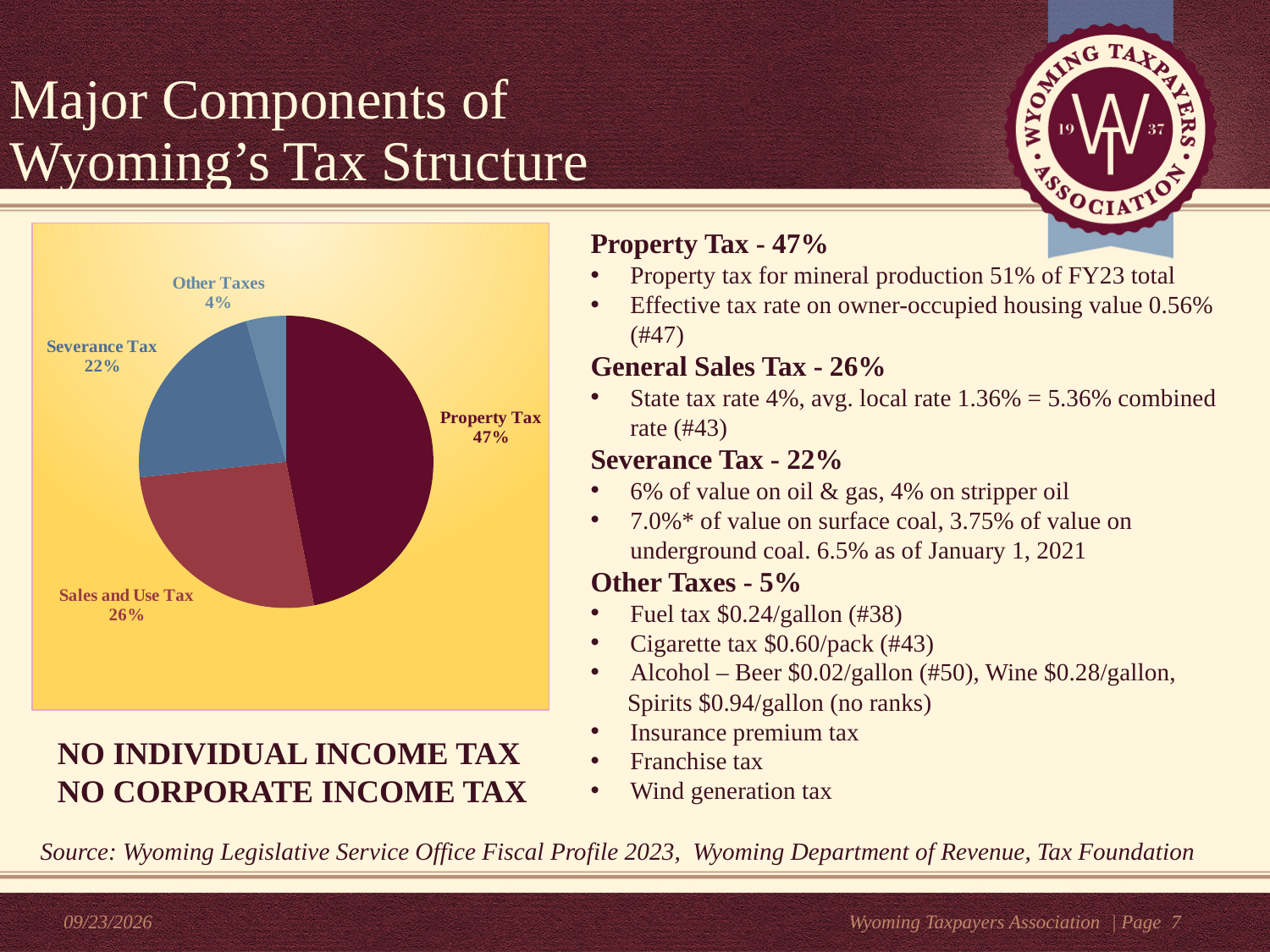
What is the value shown for Sales and Use Tax in the pie chart? 26% What kind of chart is shown on the slide? pie chart What share of the pie does Property Tax represent? 47% What is the difference in percentage points between Property Tax and Sales and Use Tax? 21 How many slices does the pie chart have? 4 Which slice of the pie chart is the smallest? Other Taxes What is the difference in percentage points between Severance Tax and Other Taxes? 18 Which is larger in the pie chart, Severance Tax or Sales and Use Tax? Sales and Use Tax What is the value shown for Other Taxes in the pie chart? 4% What colour is the Property Tax slice in the pie chart? dark maroon What is the value shown for Severance Tax in the pie chart? 22% Which slice of the pie chart is the largest? Property Tax